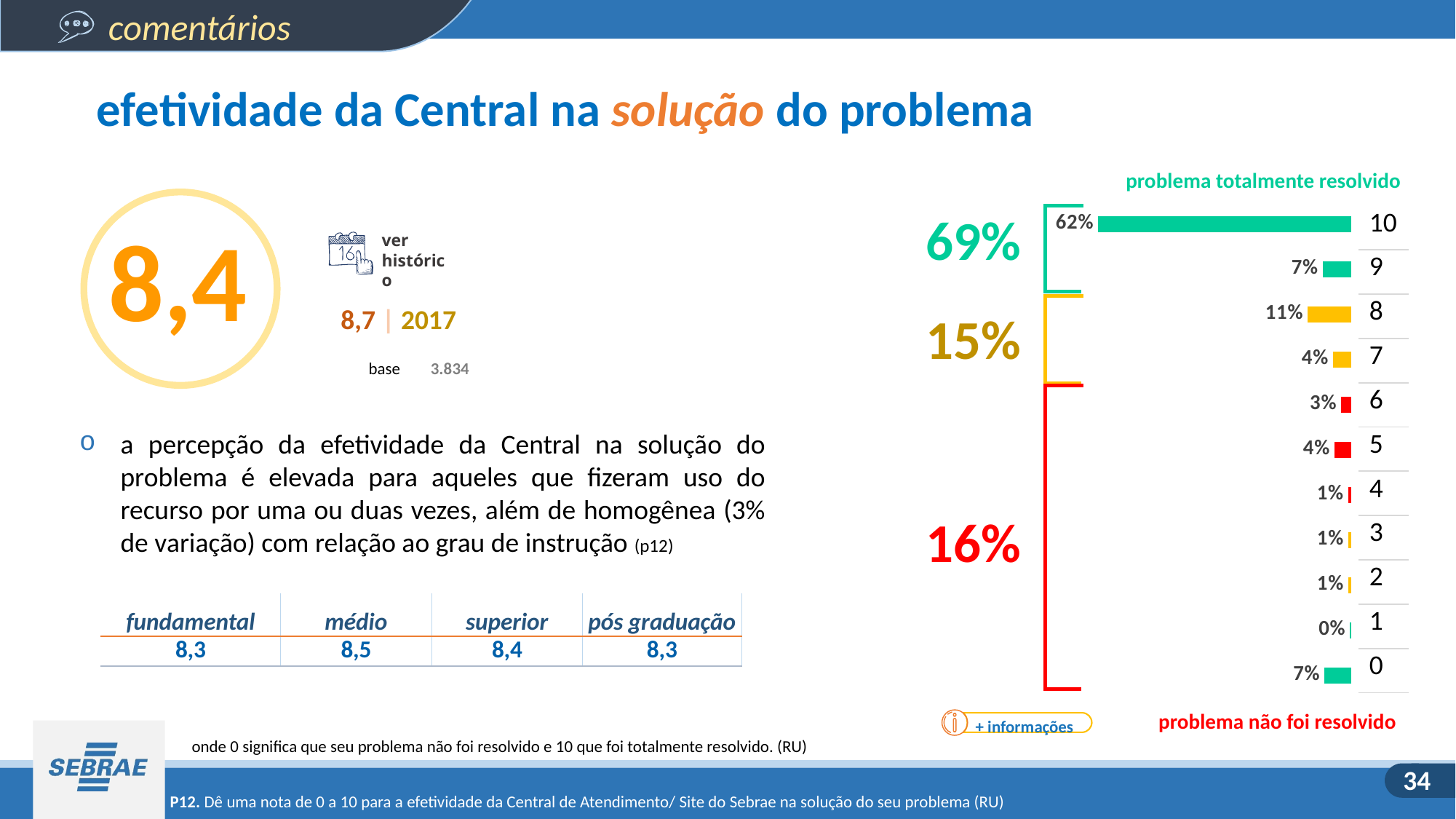
Which has a larger share of respondents: score 8 or score 7? Score 8 Which score category has the lowest percentage of respondents? 1 What is the combined percentage shown for scores 0 to 6 (problema não foi resolvido)? 16% What is the combined percentage for scores 9 and 10 (problema totalmente resolvido) shown beside the chart? 69% What label appears at the top of the bar chart above the score of 10? problema totalmente resolvido Which score category has the highest percentage of respondents? 10 What percentage of respondents gave a score of 10 for the effectiveness of the Central in solving the problem? 62% What percentage of respondents gave a score of 8? 11% What percentage of respondents gave a score of 0? 7% What type of chart is used to show the distribution of scores? Bar chart How many score categories are shown in the bar chart? 11 What is the difference in percentage points between the share giving a score of 10 and the share giving a score of 9? 55